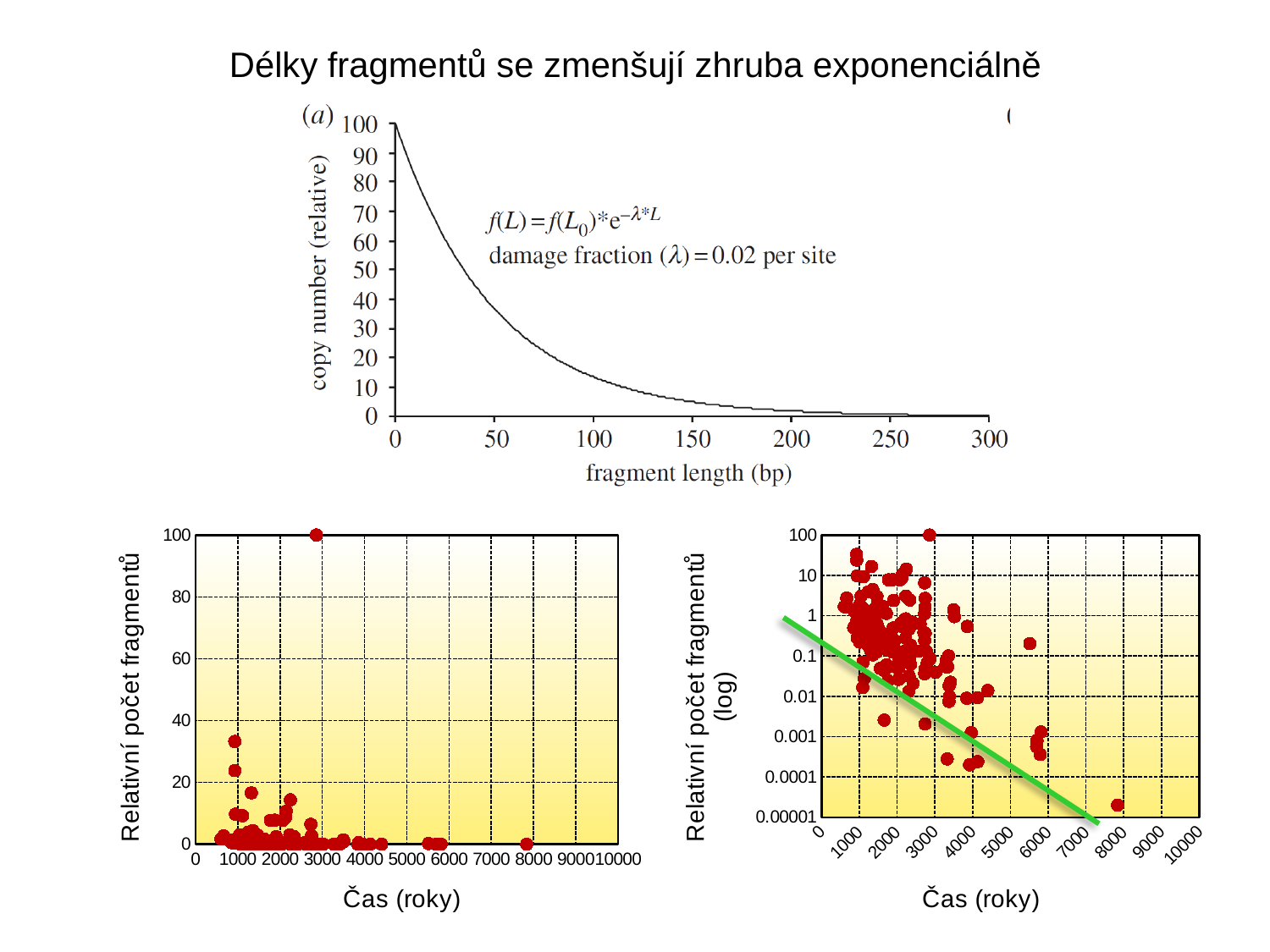
In the bottom-right chart (log scale), is the value of the point near 8000 years greater or less than 0.0001? less In the top chart, do the values rise or fall as fragment length increases? fall In the top chart, what is the copy number (relative) at fragment length 0? 100 In the top chart, is the copy number at fragment length 100 greater or less than 20? less In the bottom-left chart, do the values generally rise or fall as 'Čas (roky)' increases? fall What is the x-axis label of the top chart? fragment length (bp) In the top chart, is the copy number at fragment length 50 greater or less than 50? less In the top chart, what is the damage fraction (λ) stated in the annotation? 0.02 per site What kind of chart is the top chart with the x axis 'fragment length (bp)'? line chart What kind of chart is the bottom-left chart with the x axis 'Čas (roky)'? scatter chart In the bottom-right chart (log scale), does the green trend line rise or fall as 'Čas (roky)' increases? fall In the bottom-left chart, what is the highest value of 'Relativní počet fragmentů' reached by any point? 100